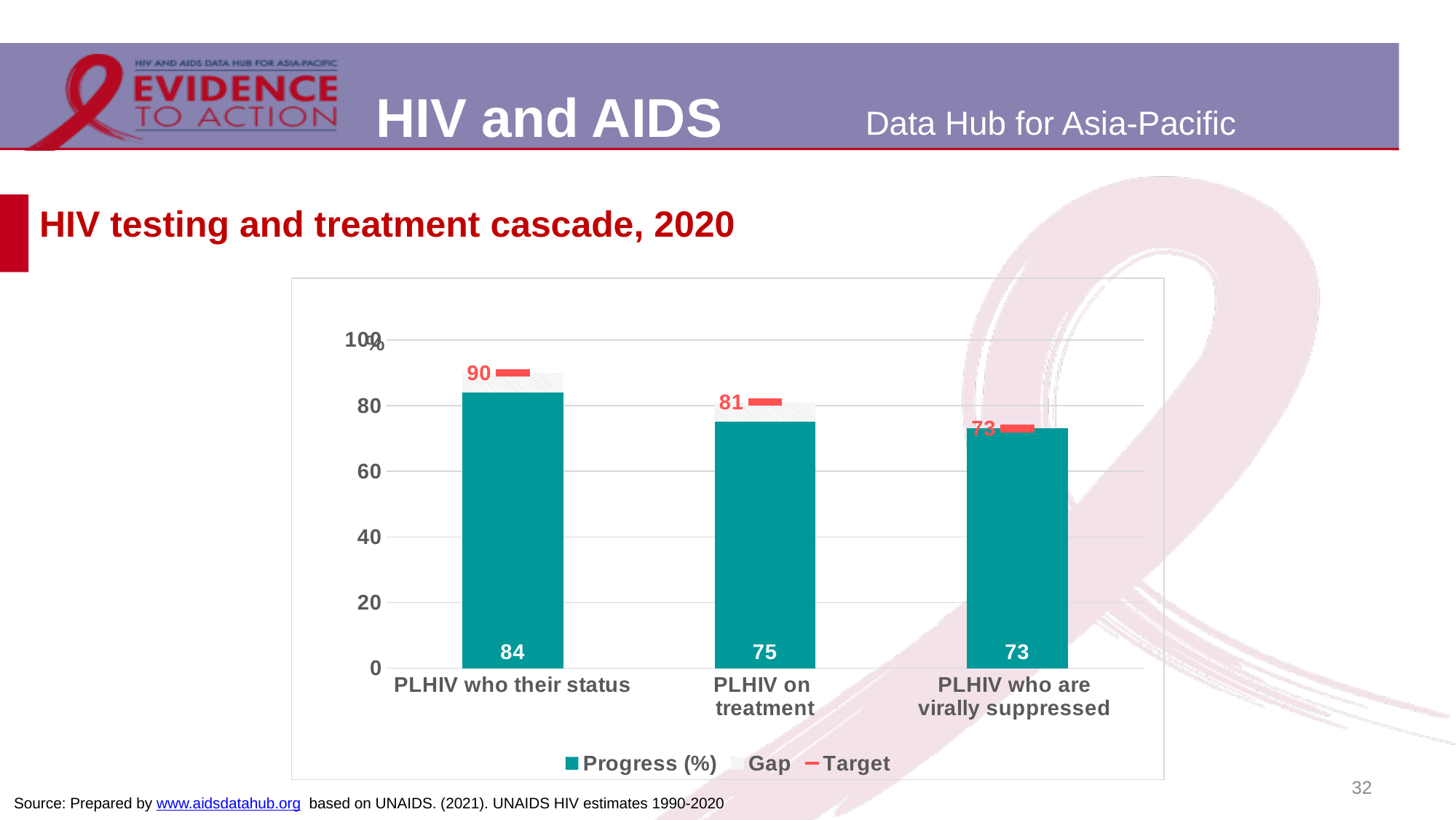
What kind of chart is shown on the slide? Bar chart Which category has the highest Progress (%) value? PLHIV who their status How many series does the legend list? 3 Which is larger: the Progress (%) for PLHIV who their status or for PLHIV on treatment? PLHIV who their status How many categories are shown on the x axis? 3 What is the Progress (%) value for PLHIV who are virally suppressed? 73 What is the difference between the Target and the Progress (%) for PLHIV who their status? 6 What is the Progress (%) value for PLHIV on treatment? 75 Do the Progress (%) values rise or fall from left to right along the x axis? Fall What is the Target value for PLHIV who their status? 90 Which category has the lowest Target value? PLHIV who are virally suppressed What is the Target value for PLHIV on treatment? 81